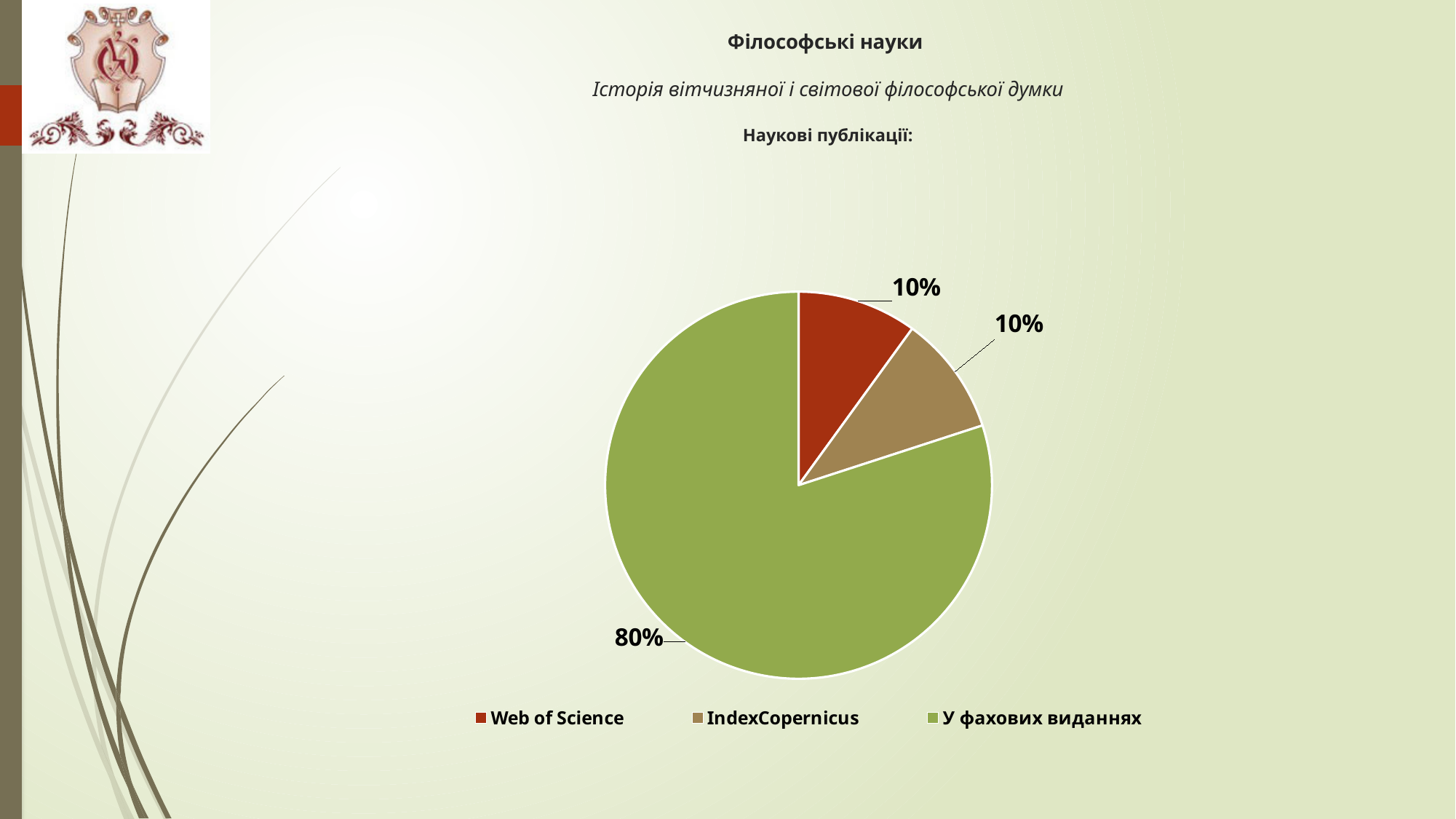
Which is larger, the slice for 'У фахових виданнях' or the slice for 'IndexCopernicus'? У фахових виданнях What share of the pie does 'У фахових виданнях' take? 80% How many entries does the legend list? 3 What colour is the 'Web of Science' slice? red What is the heading shown directly above the chart? Наукові публікації: What is the value shown for 'Web of Science'? 10% What kind of chart is shown on the slide? pie chart How many slices does the pie chart have? 3 What is the difference between the 'У фахових виданнях' share and the 'Web of Science' share? 70% Which category has the largest slice of the pie? У фахових виданнях What is the value shown for 'IndexCopernicus'? 10%